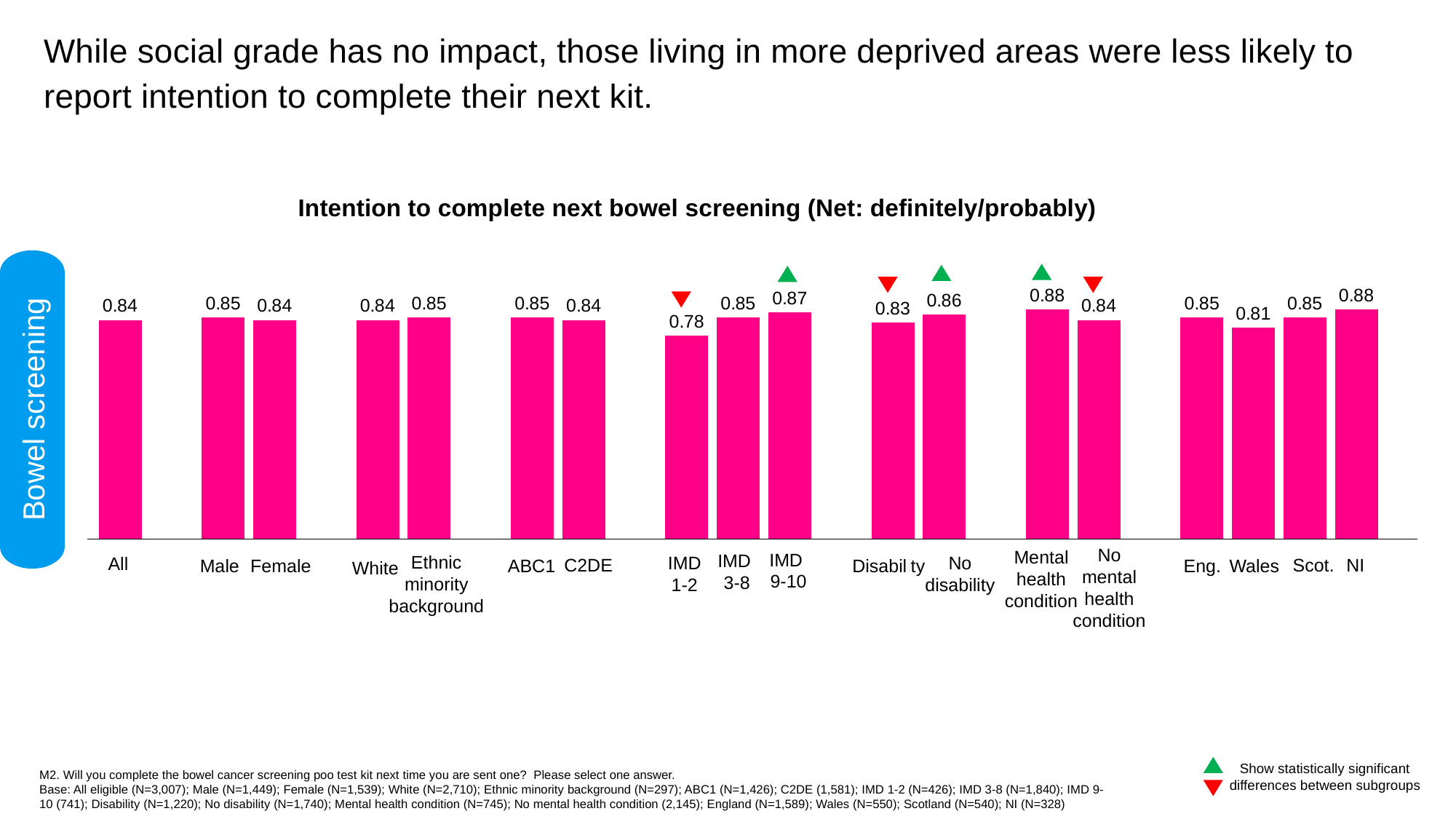
Which is larger, the value for Disability or the value for No disability? No disability What is the value for IMD 1-2? 0.78 What is the difference between the values for IMD 9-10 and IMD 1-2? 0.09 What is the value for No disability? 0.86 What is the title of the chart? Intention to complete next bowel screening (Net: definitely/probably) What is the value for Wales? 0.81 Which category has the lowest value? IMD 1-2 What kind of chart is shown on the slide? Bar chart How many bars are plotted in the chart? 18 What is the difference between the values for NI and Wales? 0.07 What is the value for Mental health condition? 0.88 Which is larger, the value for IMD 1-2 or the value for IMD 3-8? IMD 3-8